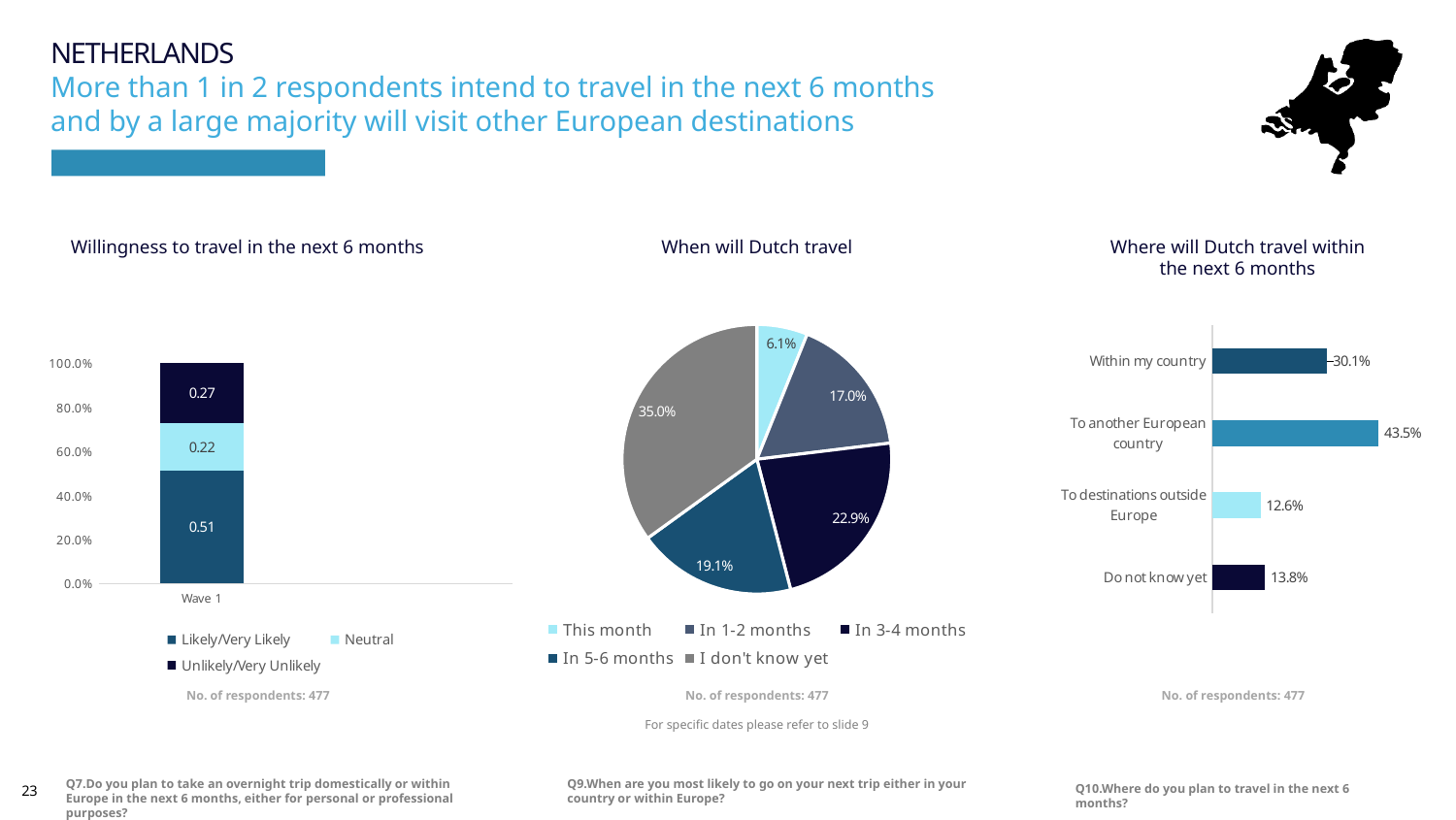
In the 'When will Dutch travel' pie chart, which slice is the smallest? This month In the 'Willingness to travel in the next 6 months' chart, what is the value for Neutral? 0.22 In the 'When will Dutch travel' pie chart, what is the difference between 'In 1-2 months' and 'This month'? 10.9% What kind of chart is 'Where will Dutch travel within the next 6 months'? Bar chart In the 'When will Dutch travel' pie chart, what share is 'In 3-4 months'? 22.9% In the 'When will Dutch travel' pie chart, which slice is the largest? I don't know yet In the 'Willingness to travel in the next 6 months' chart, what is the value for Likely/Very Likely in Wave 1? 0.51 In the 'Where will Dutch travel within the next 6 months' chart, which is larger: 'To destinations outside Europe' or 'Do not know yet'? Do not know yet In the 'Where will Dutch travel within the next 6 months' chart, what is the value for 'To another European country'? 43.5% In the 'Where will Dutch travel within the next 6 months' chart, how many categories are shown? 4 In the 'Willingness to travel in the next 6 months' chart, how many series does the legend list? 3 In the 'Willingness to travel in the next 6 months' chart, what is the total of the stacked bar for Wave 1? 1.00